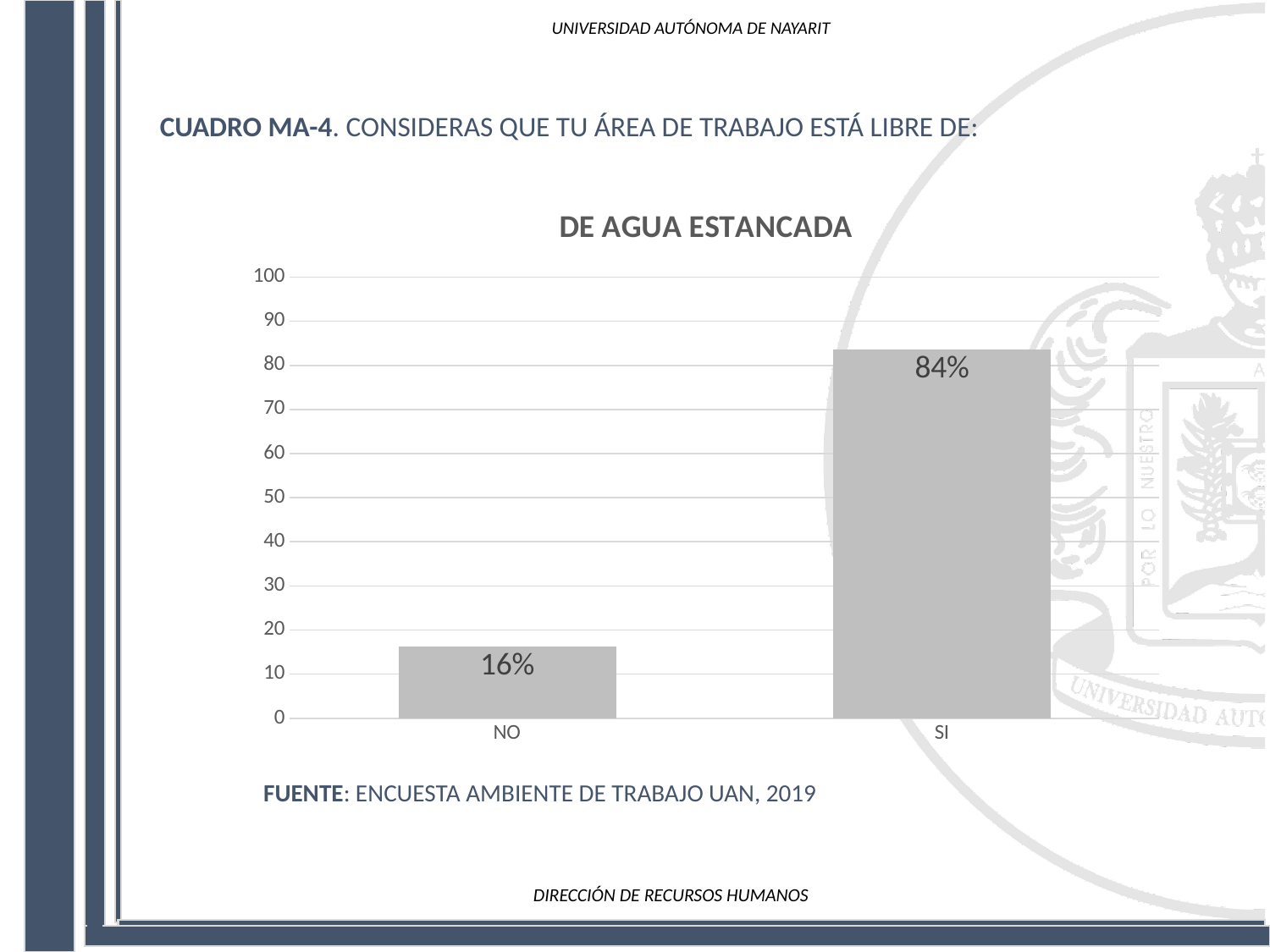
What is the difference between the values for SI and NO? 68% What is the value for NO? 16% What is the maximum value shown on the y axis? 100 Which category has the lowest value? NO Which is larger, the value for NO or the value for SI? SI Is the value for NO greater or less than 20? less What is the title of the chart? DE AGUA ESTANCADA Is the value for SI greater or less than 80? greater What kind of chart is shown? bar chart What is the value for SI? 84% How many categories are shown on the x axis? 2 Which category has the highest value? SI